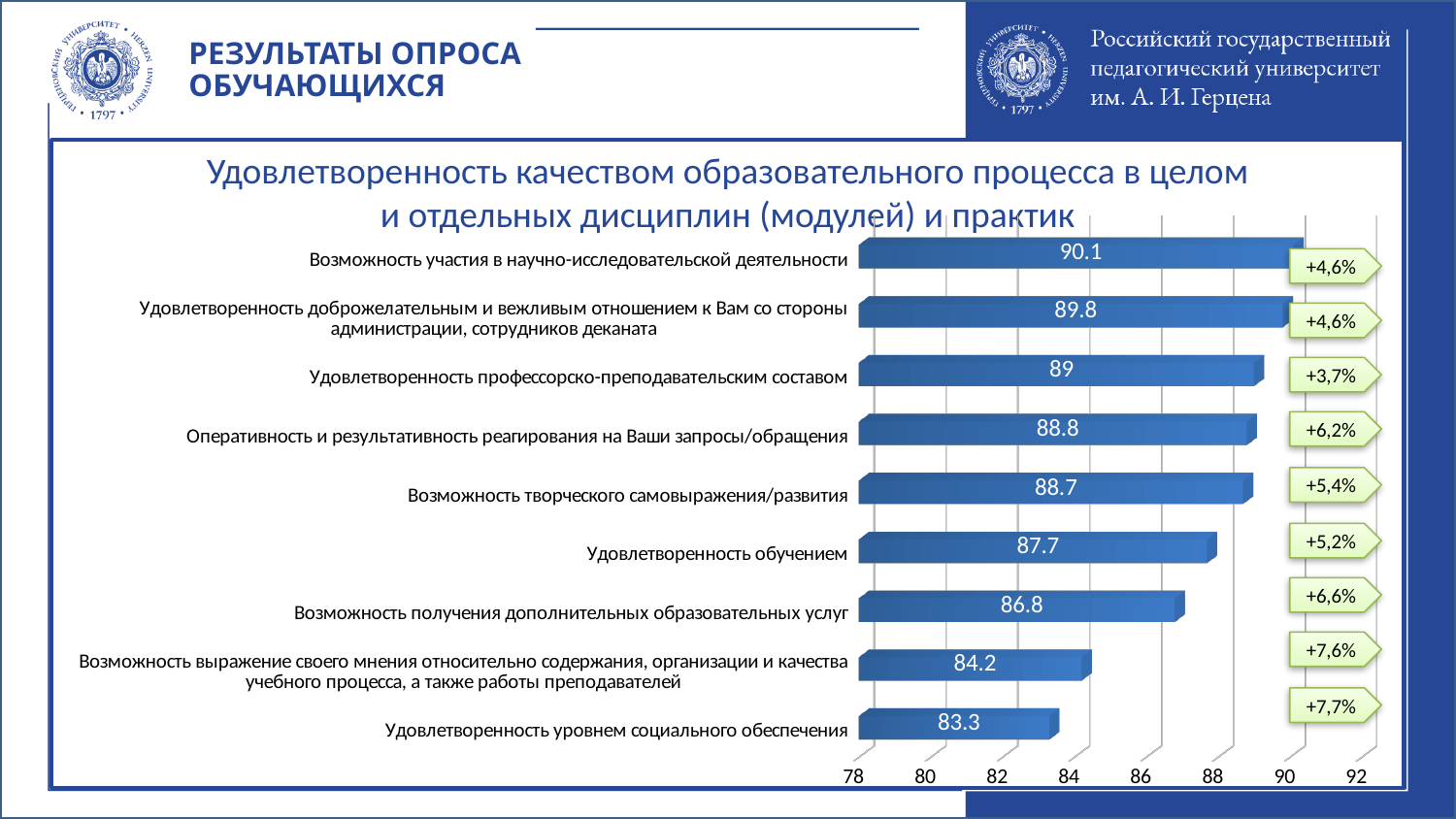
Значение для «Возможность получения дополнительных образовательных услуг» больше или меньше 88? меньше Какая разница между значениями «Возможность получения дополнительных образовательных услуг» и «Возможность выражение своего мнения относительно содержания, организации и качества учебного процесса, а также работы преподавателей»? 2.6 Какой тип диаграммы показан на слайде? Столбчатая (горизонтальная) диаграмма Какая категория имеет наименьшее значение на диаграмме? Удовлетворенность уровнем социального обеспечения Какое значение показано для категории «Возможность участия в научно-исследовательской деятельности»? 90.1 Какое значение показано для категории «Удовлетворенность уровнем социального обеспечения»? 83.3 Какая категория имеет наибольшее значение на диаграмме? Возможность участия в научно-исследовательской деятельности Какое значение показано для категории «Удовлетворенность обучением»? 87.7 Что больше: значение «Удовлетворенность обучением» или «Возможность творческого самовыражения/развития»? Возможность творческого самовыражения/развития На сколько значение «Удовлетворенность профессорско-преподавательским составом» больше значения «Удовлетворенность уровнем социального обеспечения»? 5.7 Сколько категорий показано на диаграмме? 9 Какое значение показано для категории «Оперативность и результативность реагирования на Ваши запросы/обращения»? 88.8